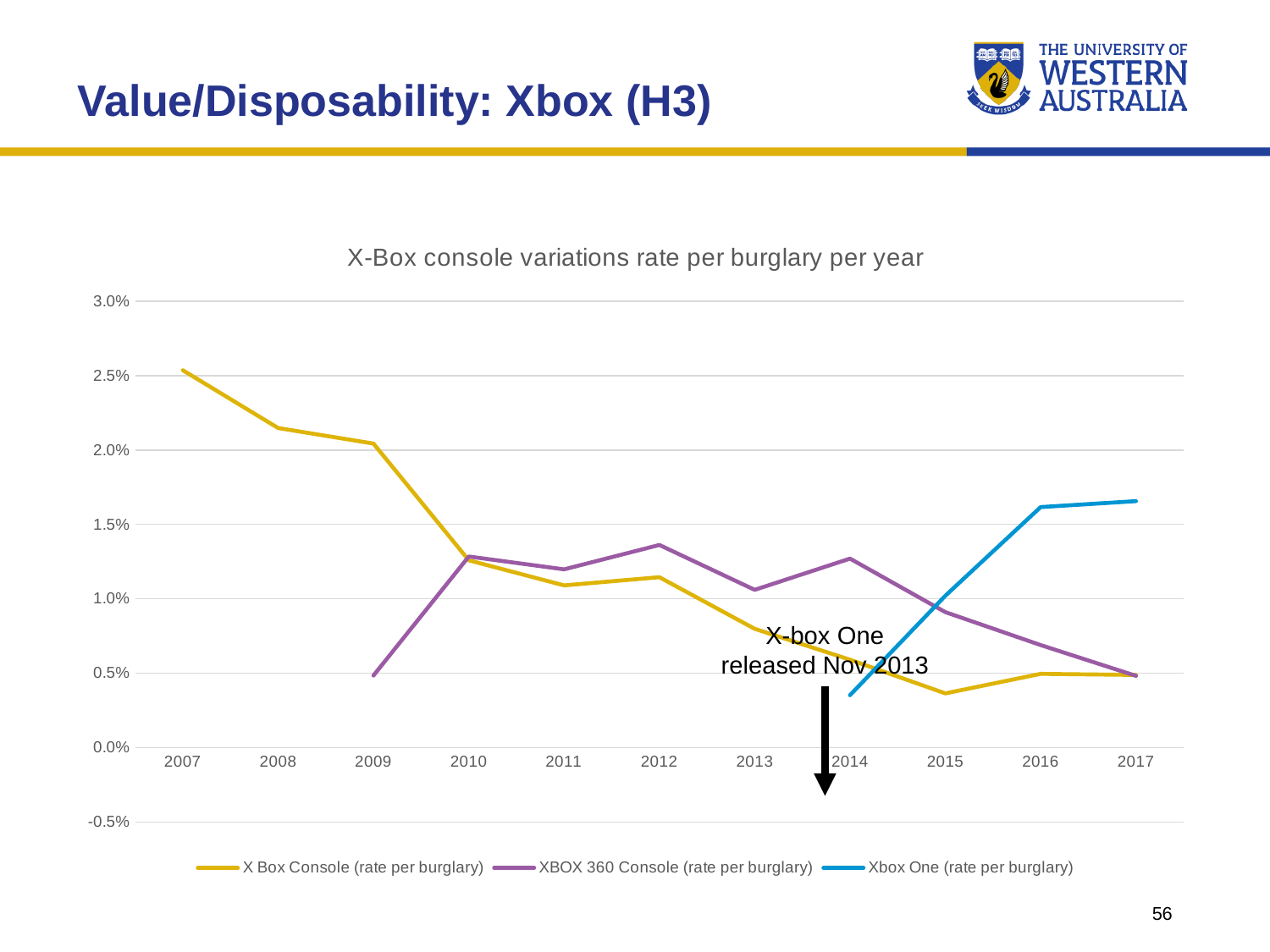
What is the title of the chart? X-Box console variations rate per burglary per year Is the value for Xbox One (rate per burglary) in 2017 greater or less than 1.5%? greater In which year is the X Box Console (rate per burglary) series at its highest? 2007 Is the value for X Box Console (rate per burglary) in 2007 greater or less than 2.0%? greater In which year does the XBOX 360 Console (rate per burglary) series reach its highest value? 2012 Does the Xbox One (rate per burglary) series rise or fall from 2014 to 2017? rise Is the value for Xbox One (rate per burglary) in 2014 greater or less than 0.5%? less What kind of chart is shown on the slide? line chart In which year is the X Box Console (rate per burglary) series at its lowest? 2015 How many series does the legend list? 3 How many years are shown on the x axis? 11 In 2016, which series has the larger value: Xbox One (rate per burglary) or XBOX 360 Console (rate per burglary)? Xbox One (rate per burglary)